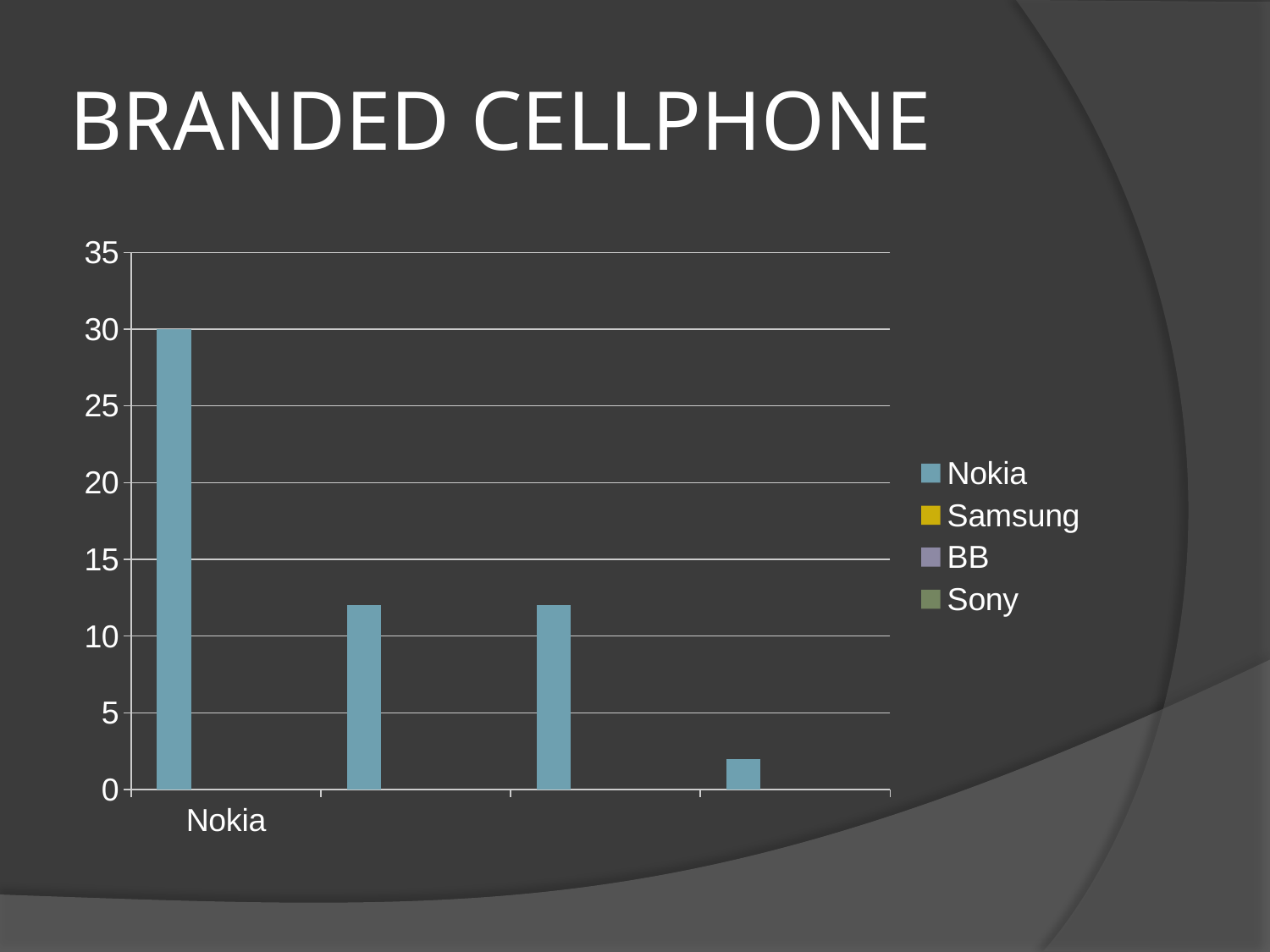
What is the title of the slide containing the chart? BRANDED CELLPHONE Which is larger, the Nokia bar or the second bar from the left? Nokia Do the bar values generally rise or fall from left to right? fall How many bars are plotted in the chart? 4 Which bar is the shortest in the chart? the fourth bar from the left What kind of chart is shown on the slide? bar chart Is the value of the second bar from the left greater or less than 15? less How many entries does the chart's legend list? 4 Is the value of the fourth bar from the left greater or less than 5? less Is the value of the third bar from the left greater or less than 10? greater Which bar is the tallest in the chart? Nokia What is the value of the bar labelled Nokia? 30